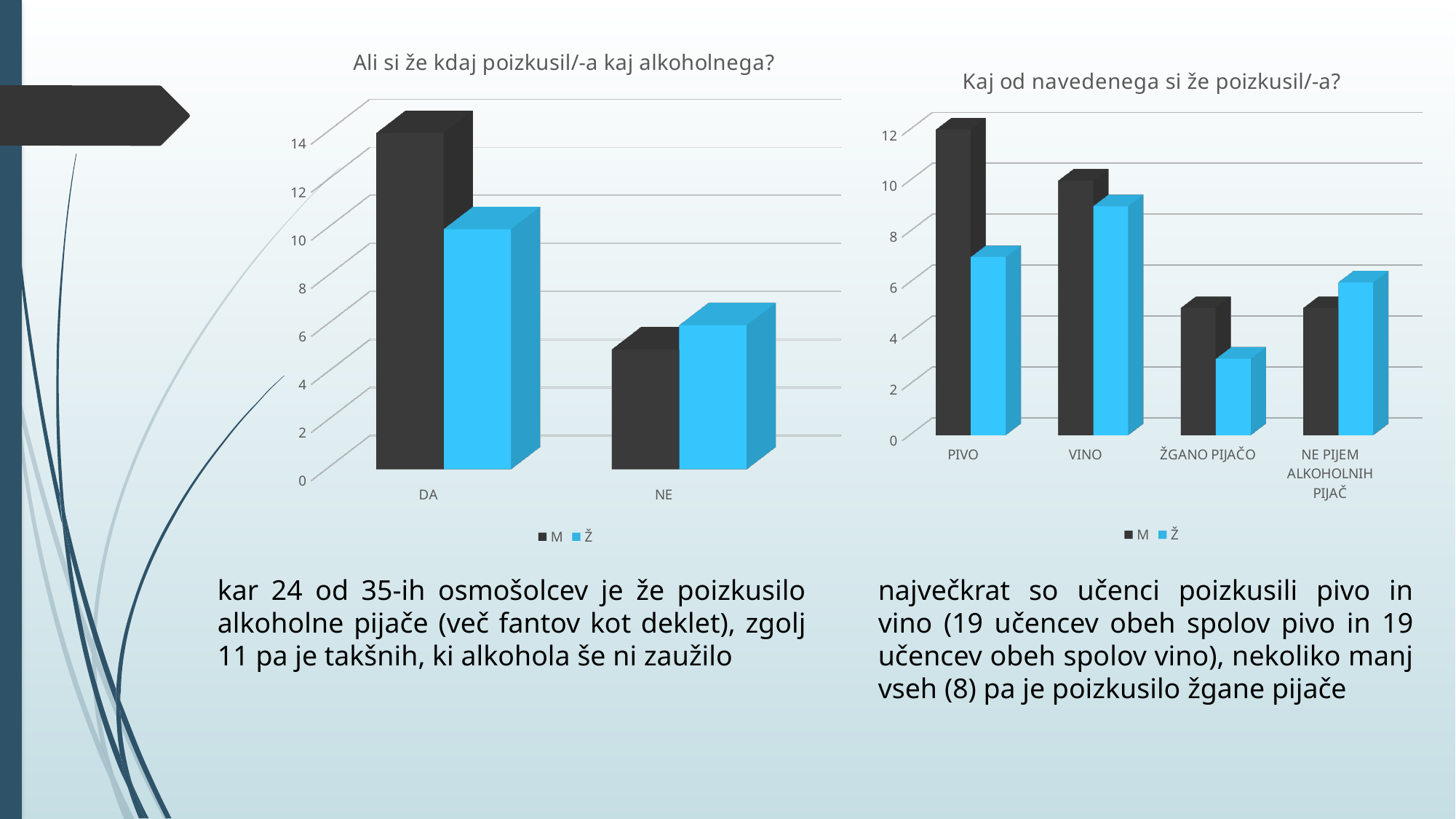
What kind of chart is the left chart titled "Ali si že kdaj poizkusil/-a kaj alkoholnega?"? bar chart In the left chart, is the value for Ž in the DA category greater or less than 8? greater In the right chart, which category has the lowest value for the Ž series? ŽGANO PIJAČO In the right chart, is the value for Ž in the ŽGANO PIJAČO category greater or less than 4? less How many categories are shown on the x axis of the right chart titled "Kaj od navedenega si že poizkusil/-a?"? 4 In the right chart, which category has the highest value for the M series? PIVO In the left chart, is the value for M in the DA category greater or less than 12? greater How many series does the legend of the left chart list? 2 In the left chart, which series has the larger value for DA, M or Ž? M In the right chart, which series has the larger value for PIVO, M or Ž? M